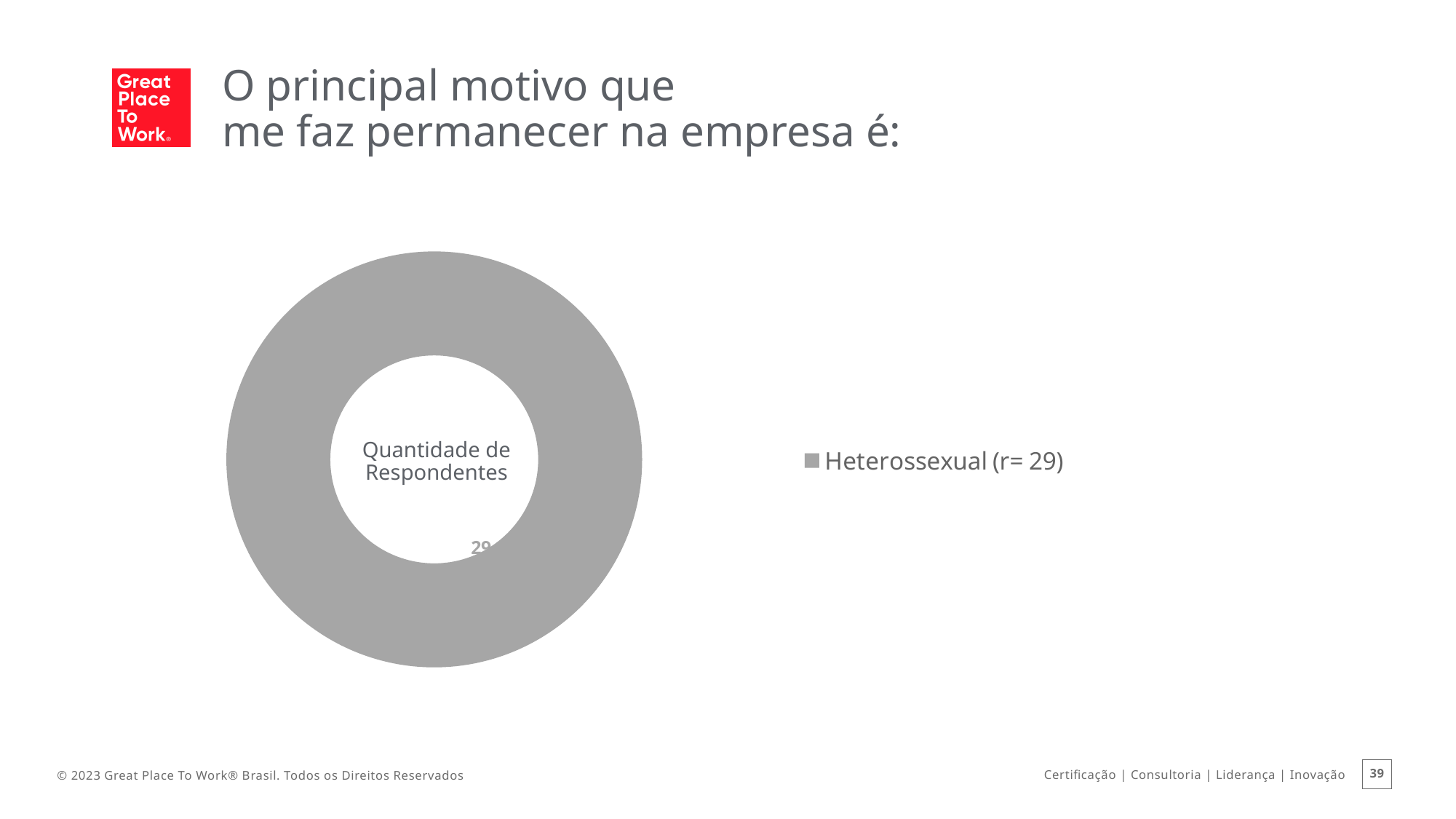
Is the value for Heterossexual greater or less than 20? greater How many categories does the legend of the chart list? 1 What is the only legend entry of the chart? Heterossexual (r= 29) What text is written in the centre of the doughnut chart? Quantidade de Respondentes What kind of chart is shown on the slide? Doughnut chart What is the value shown for Heterossexual in the chart? 29 What share of the doughnut does the Heterossexual slice represent? 100% How many slices does the doughnut chart have? 1